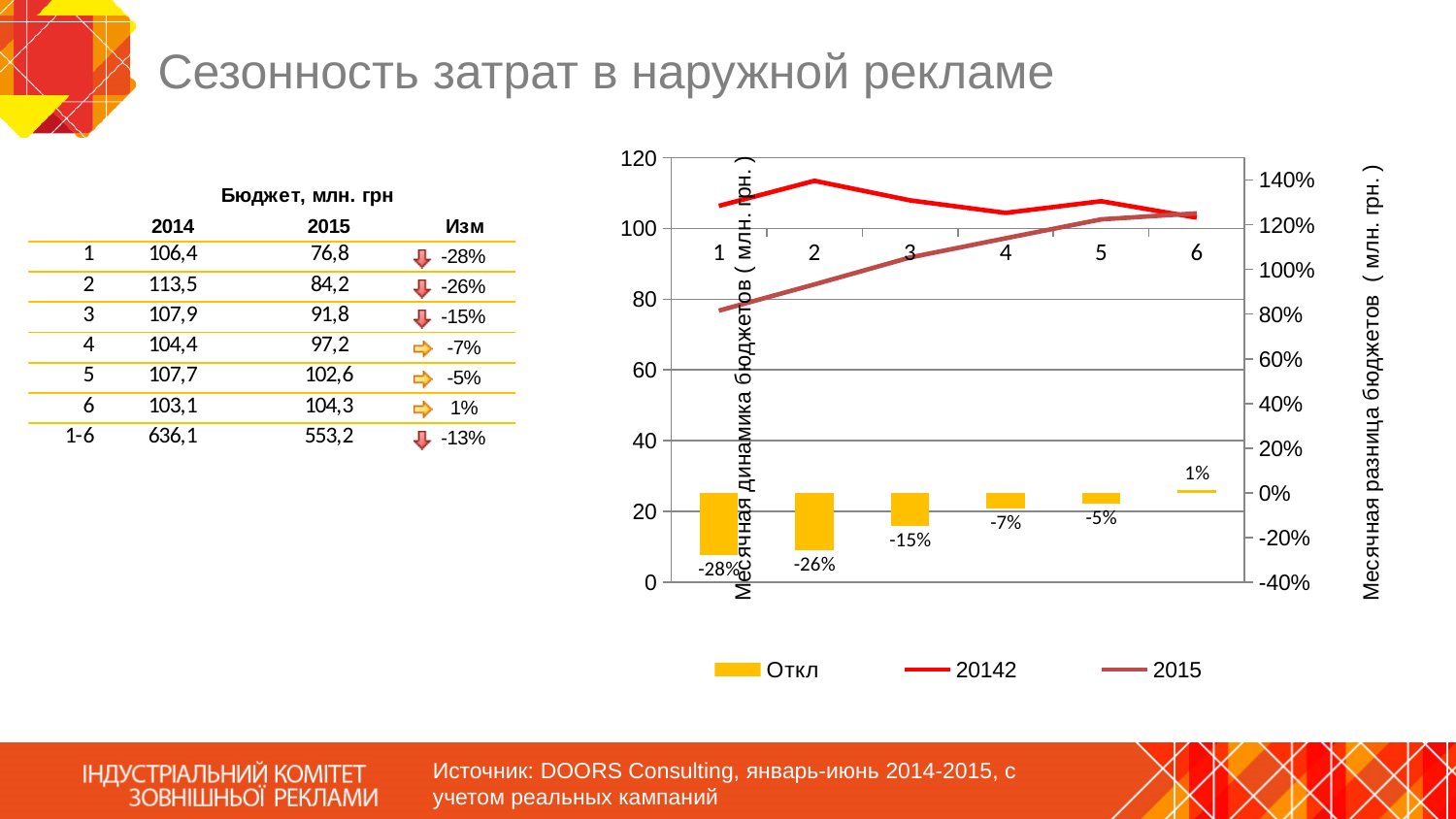
Which month has the lowest Откл value? 1 What is the value of the Откл bar for month 1? -28% What is the value of the Откл bar for month 3? -15% Does the 2015 line rise or fall from month 1 to month 6? rises Which is larger, the Откл value for month 4 or for month 5? month 5 What is the value of the Откл bar for month 6? 1% Is the value of the 2015 line at month 3 greater or less than 80? greater How many series does the chart legend list? 3 How many months are shown on the x axis of the chart? 6 What is the difference between the Откл values for month 1 and month 3? 13 percentage points Is the value of the 20142 line at month 2 greater or less than 100? greater Which month has the highest Откл value? 6